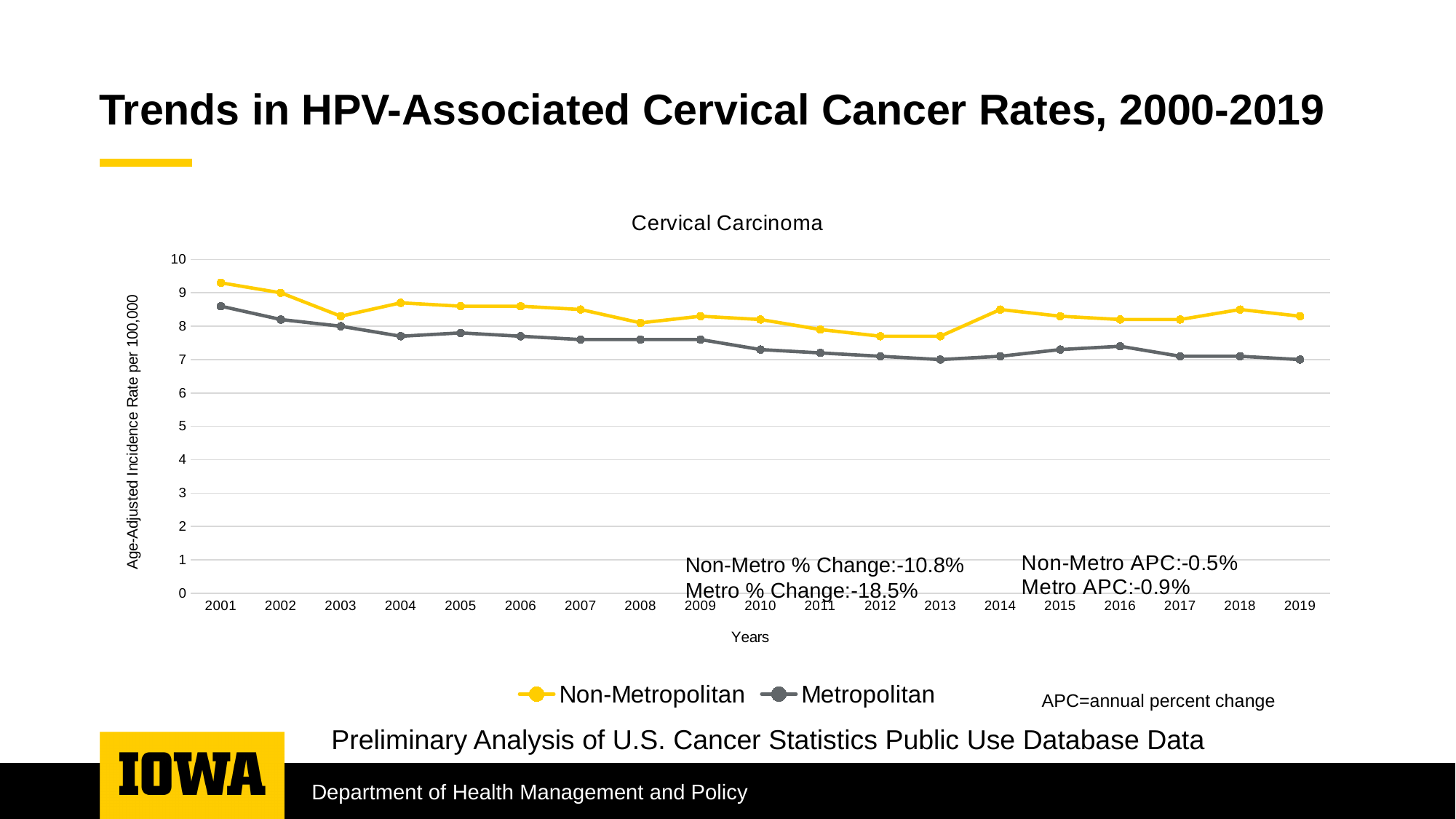
Is the Metropolitan value for 2010 greater or less than 8? less Overall, does the Metropolitan rate rise or fall from 2001 to 2019? Fall What type of chart is shown on the slide? Line chart In which year is the Metropolitan rate highest? 2001 In which year is the Non-Metropolitan rate highest? 2001 What is the Metro % Change printed on the chart? -18.5% What is the Non-Metro APC printed on the chart? -0.5% Is the Non-Metropolitan value for 2001 greater or less than 9? greater How many series does the legend list? 2 Is the Non-Metropolitan value for 2012 greater or less than 8? less How many years are plotted along the x axis? 19 Which series has the higher value in 2019, Non-Metropolitan or Metropolitan? Non-Metropolitan